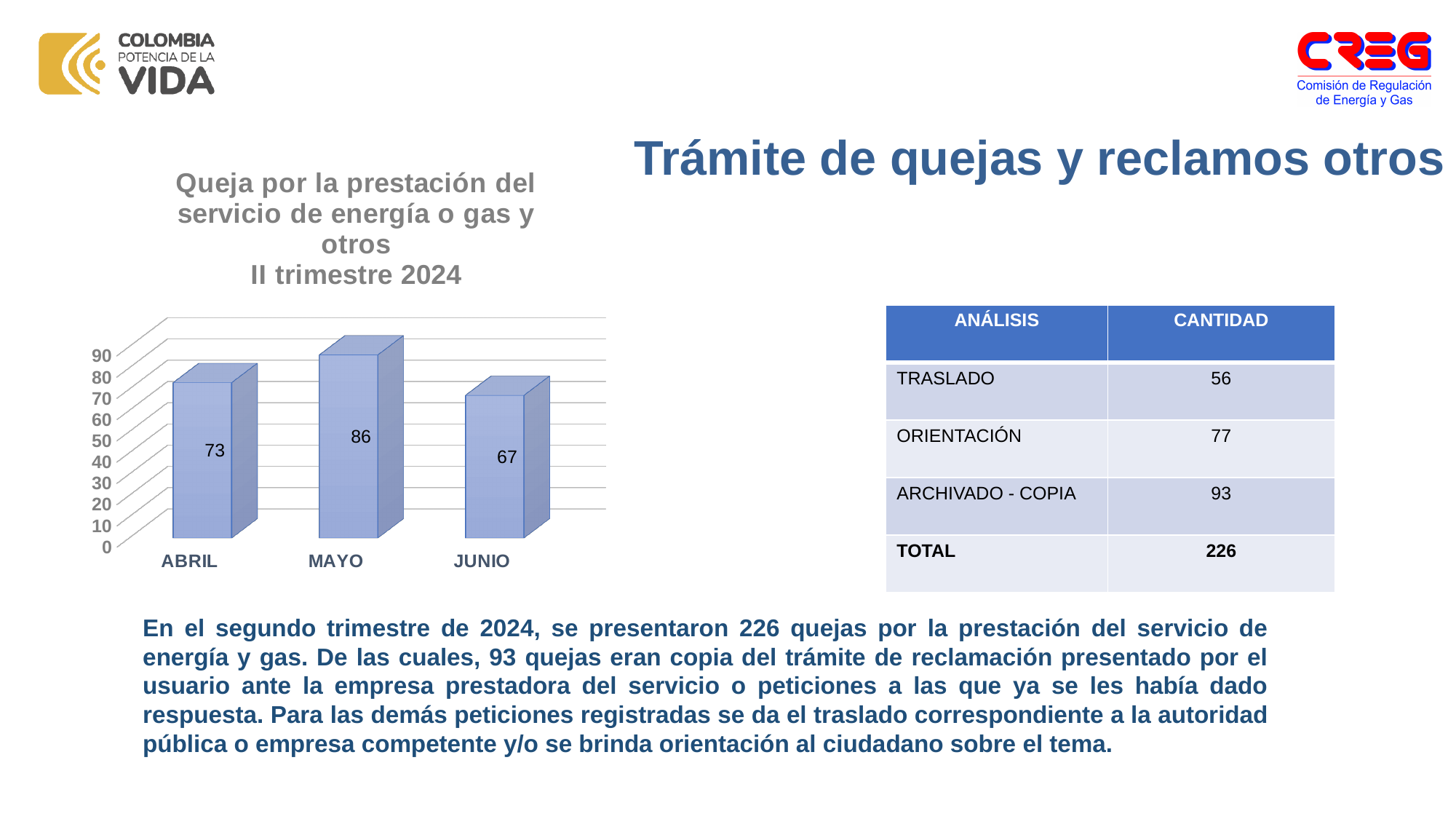
What is the value for MAYO in the chart? 86 What is the value for ABRIL in the chart? 73 What is the value for JUNIO in the chart? 67 How many months are shown on the x axis of the chart? 3 What kind of chart is shown on the slide? Bar chart Which is larger, the value for ABRIL or the value for JUNIO? ABRIL Is the value for MAYO greater or less than 80? greater What is the difference between the values for MAYO and ABRIL? 13 Which month has the lowest value in the chart? JUNIO What is the title of the chart? Queja por la prestación del servicio de energía o gas y otros II trimestre 2024 What is the difference between the values for ABRIL and JUNIO? 6 Which month has the highest value in the chart? MAYO